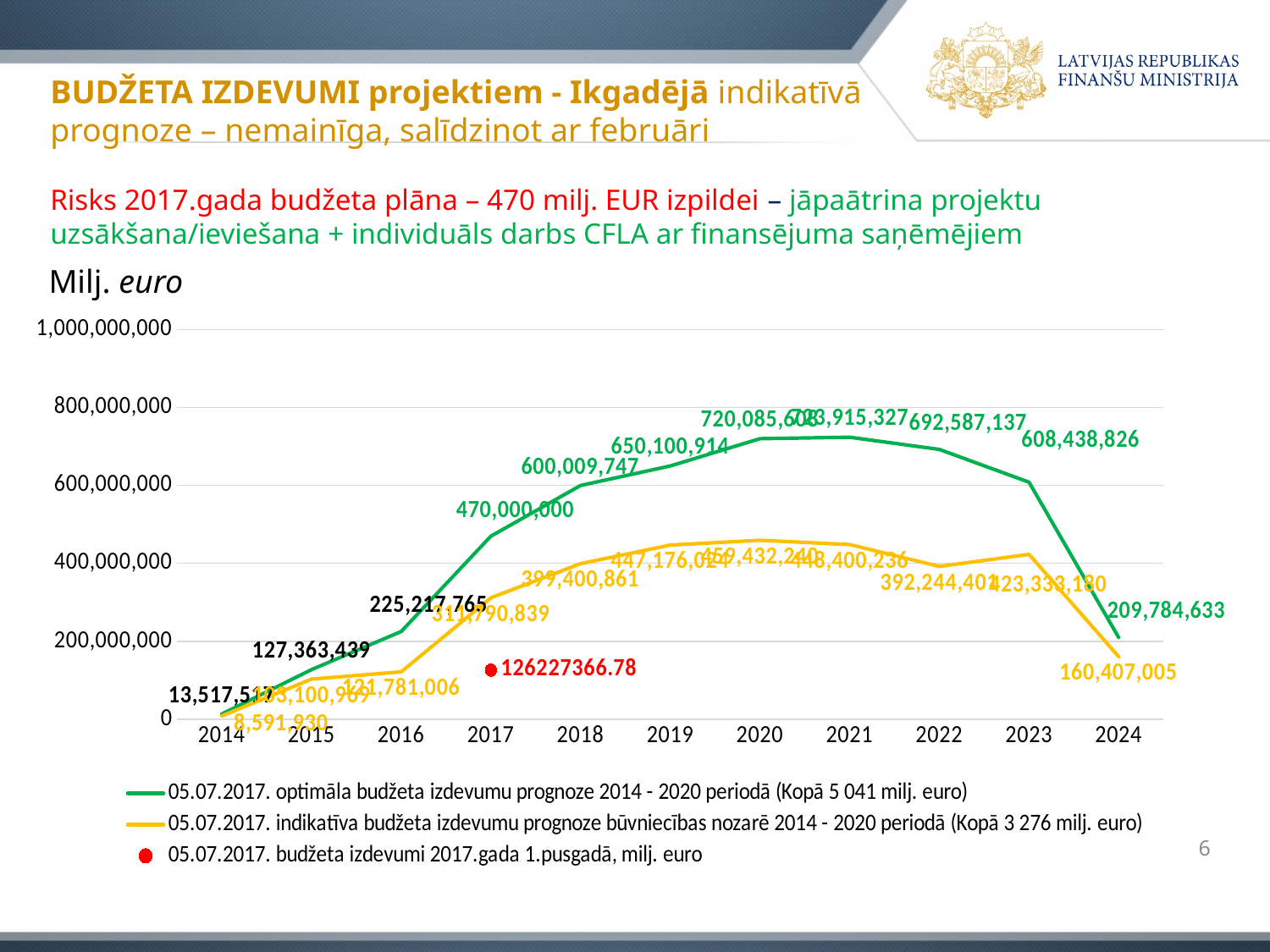
How many series does the chart legend list? 3 What is the value of the yellow line (05.07.2017. indikatīva budžeta izdevumu prognoze būvniecības nozarē) for 2018? 399,400,861 How many years are shown on the x axis of the chart? 11 Is the value of the yellow line for 2019 greater or less than 400,000,000? greater What is the value of the yellow line for 2024? 160,407,005 What value does the red dot (05.07.2017. budžeta izdevumi 2017.gada 1.pusgadā) show? 126227366.78 What is the value of the green line for 2024? 209,784,633 What is the difference between the green line values for 2017 and 2016? 244,782,235 For 2018, which line has the larger value, the green line or the yellow line? the green line What is the difference between the green line values for 2023 and 2024? 398,654,193 What is the value of the green line (05.07.2017. optimāla budžeta izdevumu prognoze) for 2017? 470,000,000 In which year is the green line (optimāla prognoze) at its lowest? 2014